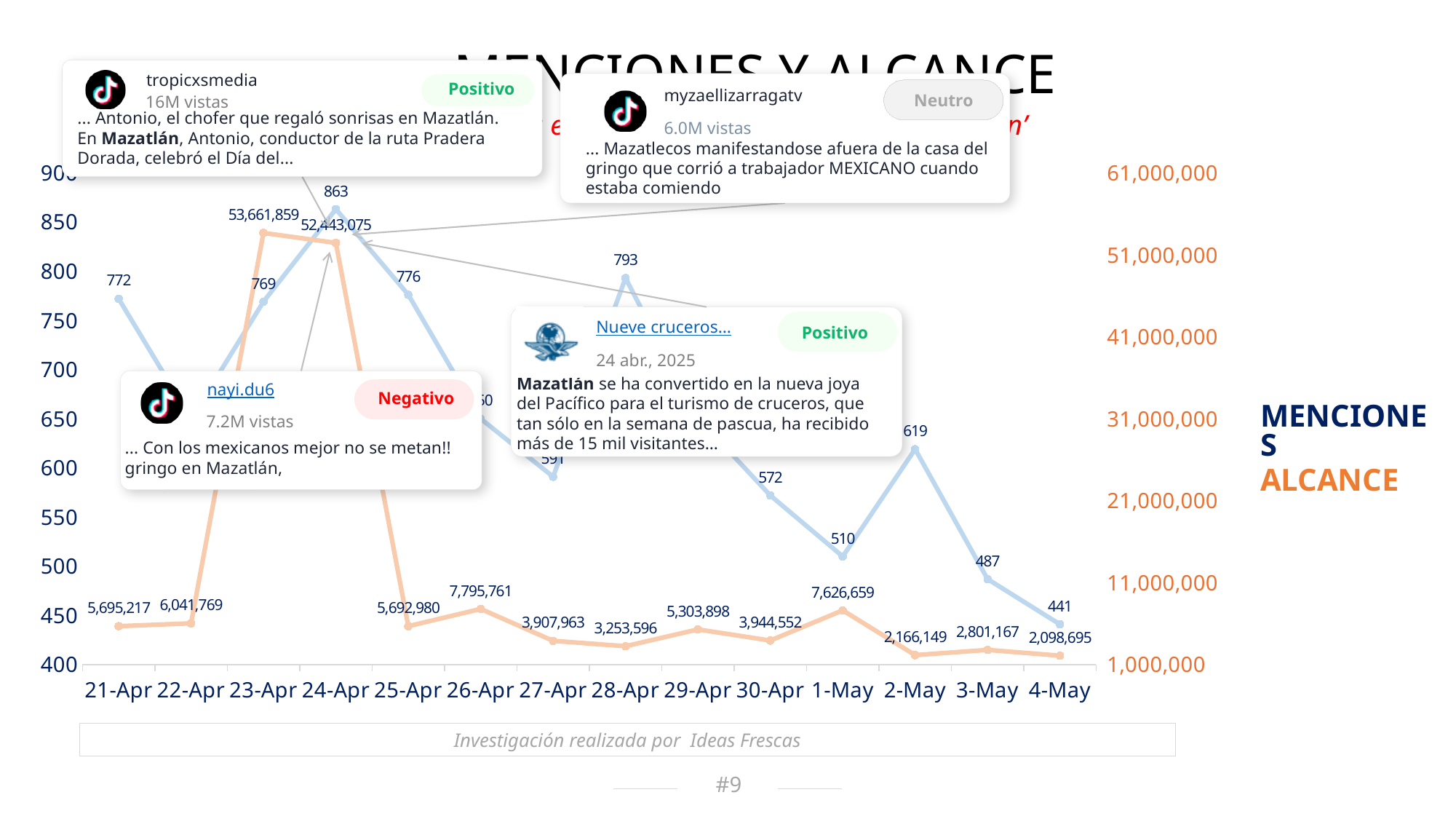
Do the MENCIONES values rise or fall from 2-May to 4-May? fall What is the difference between the MENCIONES values on 24-Apr and 4-May? 422 On which date is MENCIONES highest? 24-Apr On which date is ALCANCE lowest? 4-May What kind of chart is shown on the slide? line chart How many series does the legend list? 2 What is the ALCANCE value on 1-May? 7,626,659 On which date is MENCIONES lowest? 4-May How many dates are shown on the x axis? 14 What is the MENCIONES value on 24-Apr? 863 Which is larger, the MENCIONES value on 28-Apr or on 2-May? 28-Apr What is the ALCANCE value on 23-Apr? 53,661,859